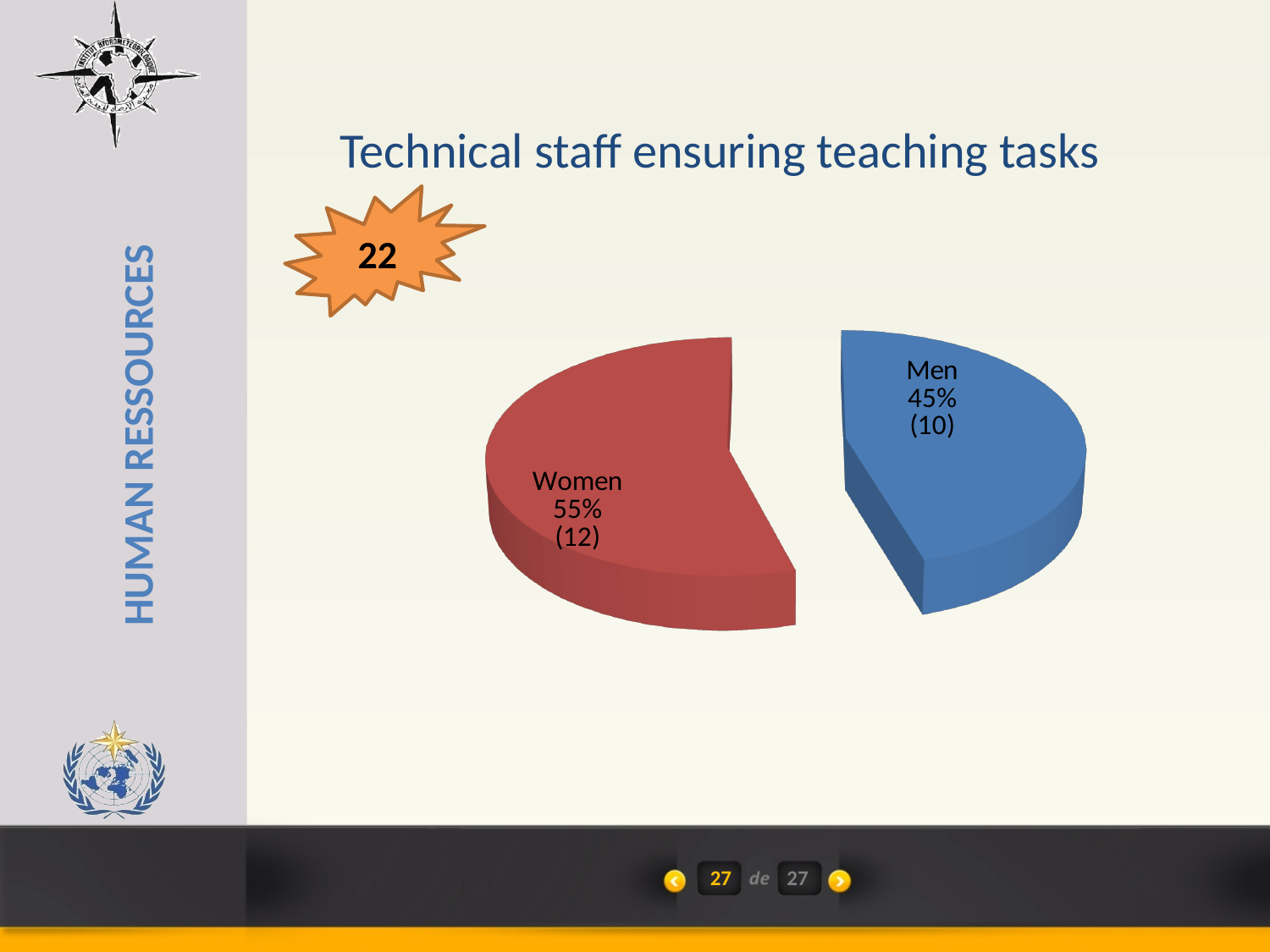
Which category has the smallest share of the pie chart? Men What is the title of the chart on the slide? Technical staff ensuring teaching tasks How many slices does the pie chart have? 2 How many men are counted in the pie chart? 10 What is the total number of technical staff shown in the pie chart (men plus women)? 22 How many women are counted in the pie chart? 12 What kind of chart is shown on the slide? pie chart What is the difference in percentage points between the Women and Men slices? 10% Which slice of the pie chart is larger, Men or Women? Women What percentage of the technical staff ensuring teaching tasks are men? 45% What colour is the Women slice of the pie chart? red What percentage of the technical staff ensuring teaching tasks are women? 55%